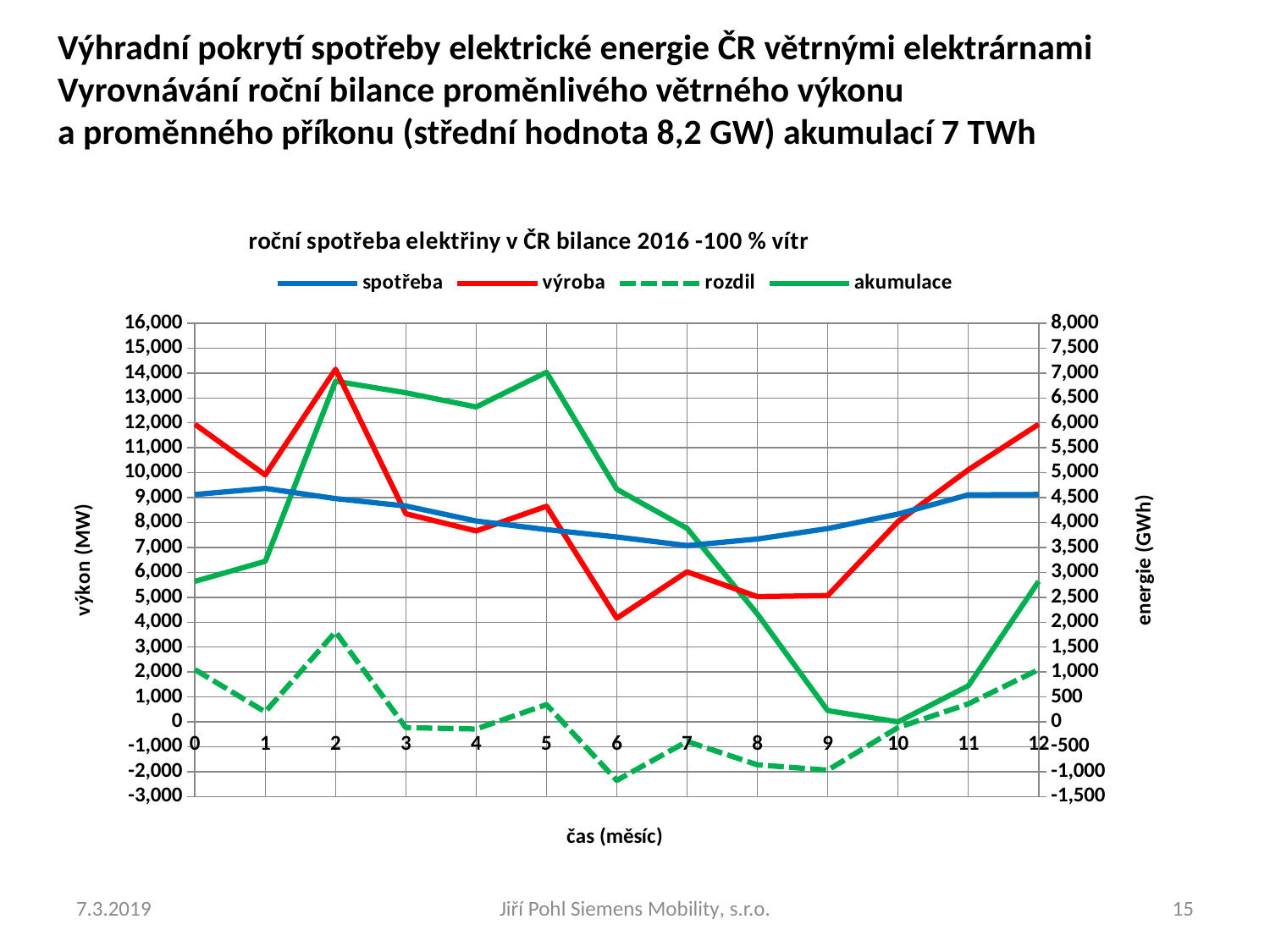
What is the title of the chart? roční spotřeba elektřiny v ČR bilance 2016 -100 % vítr How many months (x-axis points) are plotted for each series? 13 Is the value of výroba at month 6 greater or less than 5,000? less At month 6, which is larger, spotřeba or výroba? spotřeba How many series does the chart legend list? 4 What kind of chart is shown on the slide? line chart In which month does the výroba series reach its highest value? 2 In which month does the akumulace series reach its lowest value? 10 Is the value of spotřeba at month 7 greater or less than 8,000? less What is the label of the right-hand vertical axis? energie (GWh) In which month does the výroba series reach its lowest value? 6 Does the výroba series rise or fall from month 6 to month 12? rise